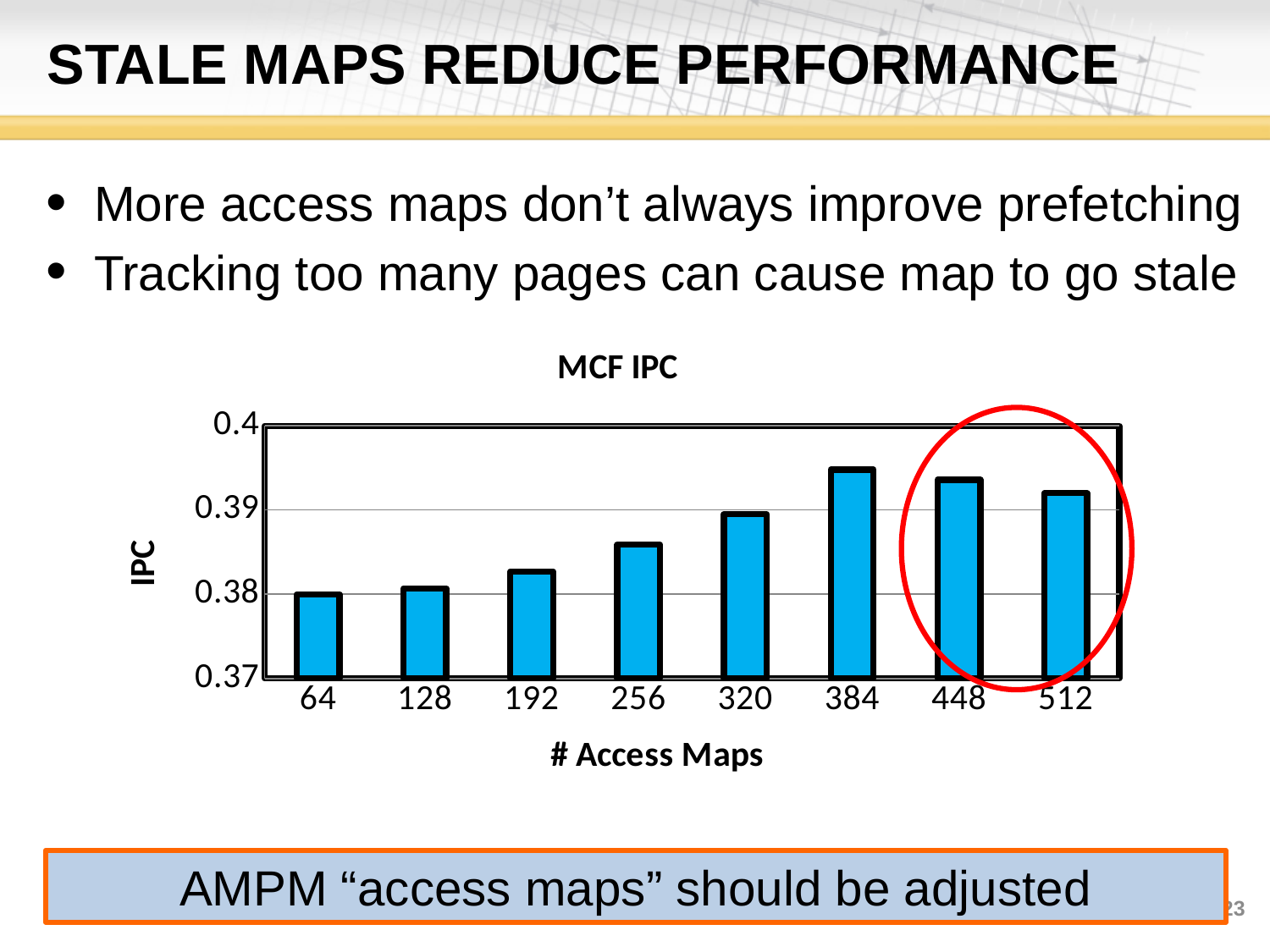
Which number of access maps has the lowest IPC? 64 Is the IPC for 256 access maps greater or less than 0.38? greater Is the IPC for 384 access maps greater or less than 0.39? greater Which has a higher IPC, 384 access maps or 512 access maps? 384 How does IPC change as the number of access maps increases from 64 to 512? rises up to 384, then falls Is the IPC for 128 access maps greater or less than 0.39? less What is the label of the x axis of the chart? # Access Maps Which number of access maps has the highest IPC? 384 What kind of chart is shown on the slide? bar chart How many bars (access map counts) are plotted in the chart? 8 What is the title of the chart? MCF IPC Which has a higher IPC, 448 access maps or 512 access maps? 448